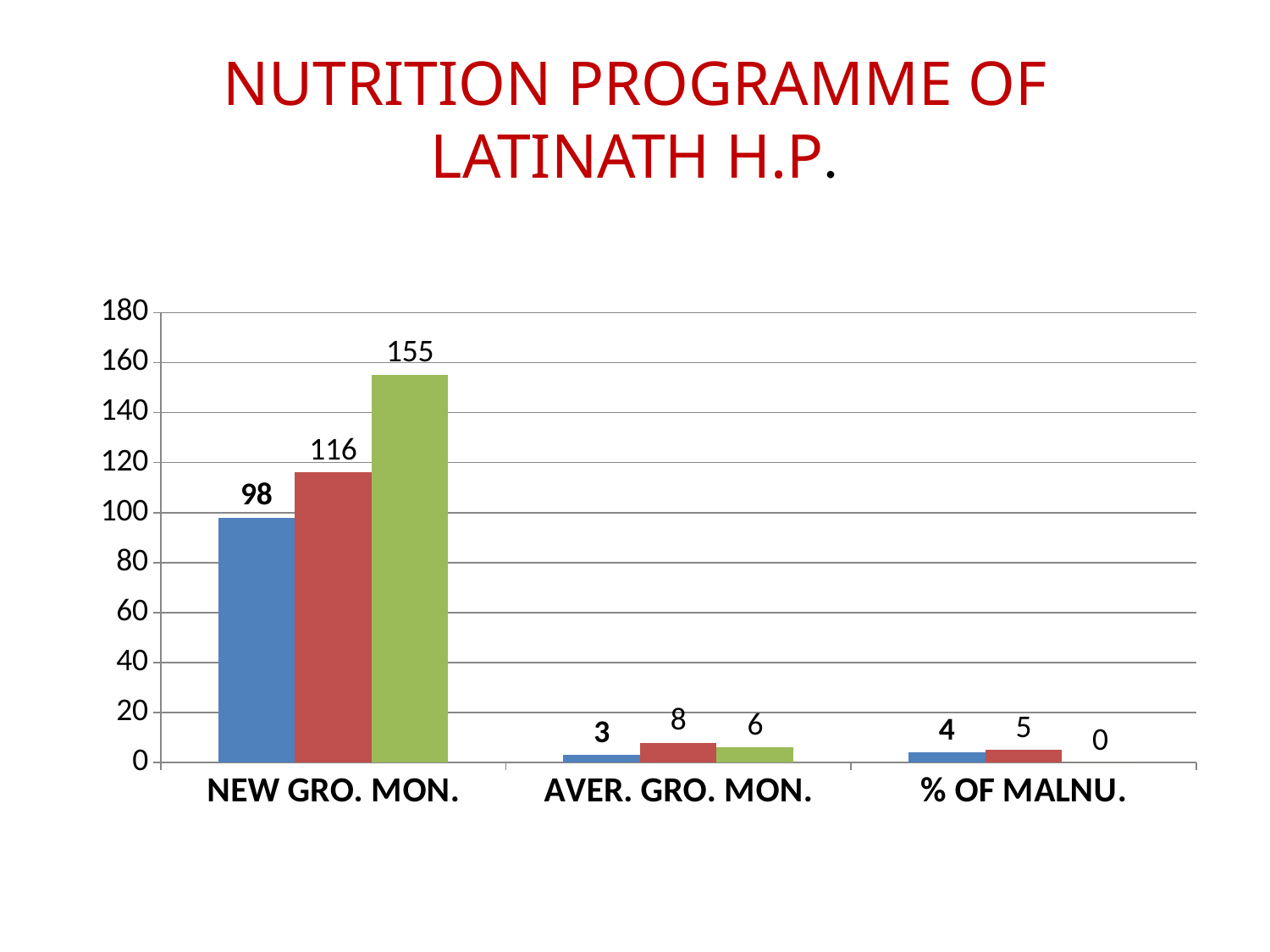
Which category has the highest bar in the chart? NEW GRO. MON. What is the difference between the green bar and the blue bar for NEW GRO. MON.? 57 What type of chart is shown on the slide? bar chart How many categories are shown on the x axis? 3 What is the value of the green bar for NEW GRO. MON.? 155 What is the value of the red bar for AVER. GRO. MON.? 8 Which bar has the lowest value in the chart? the green bar for % OF MALNU. (0) What is the value of the green bar for % OF MALNU.? 0 Which is larger for NEW GRO. MON., the red bar or the blue bar? the red bar What is the value of the blue bar for NEW GRO. MON.? 98 What is the difference between the red bar and the green bar for AVER. GRO. MON.? 2 What is the title of the slide? NUTRITION PROGRAMME OF LATINATH H.P.